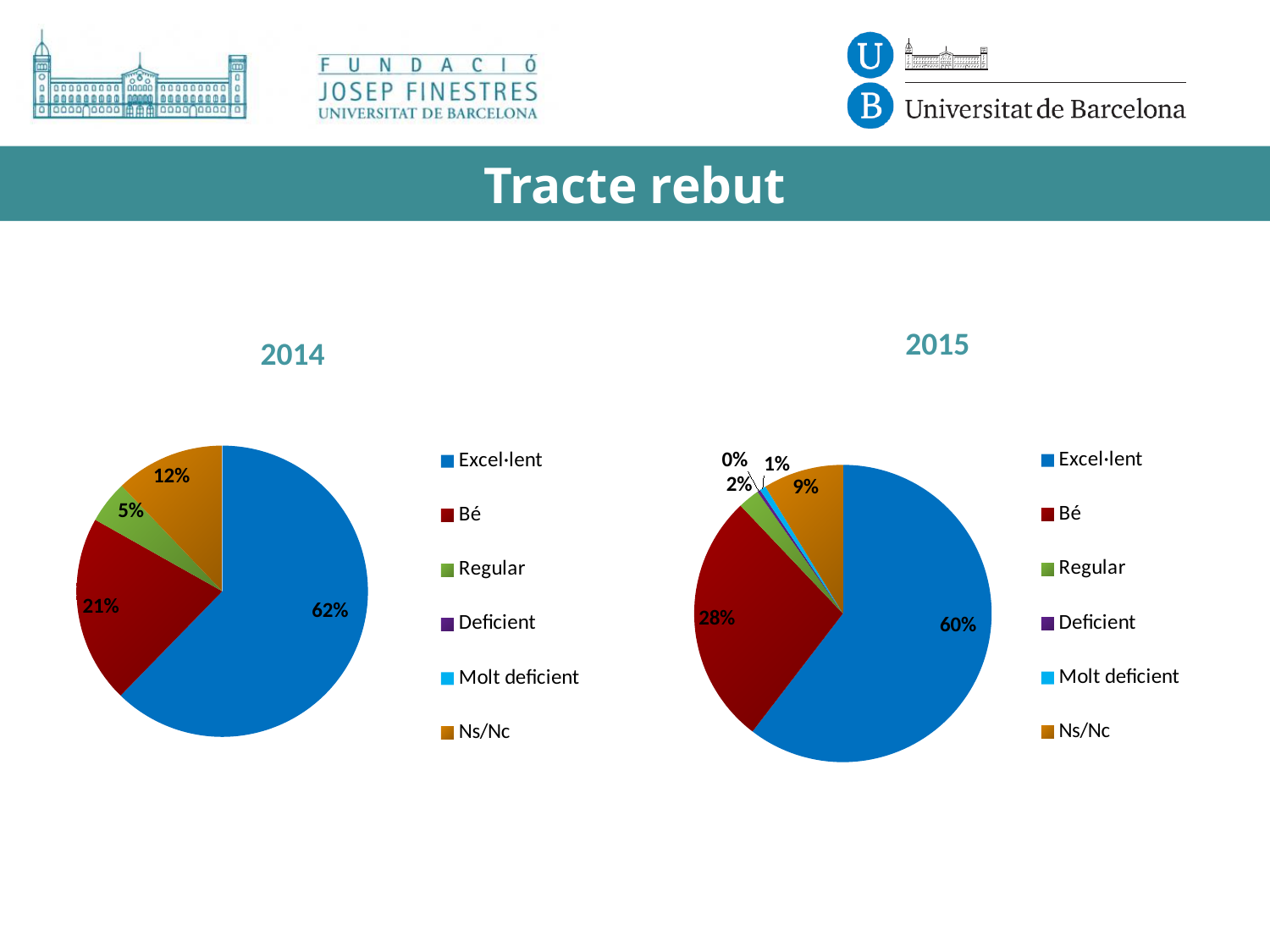
In the 2015 pie chart, what percentage is shown for Bé? 28% What is the difference between the Bé percentage in the 2015 pie chart and the Bé percentage in the 2014 pie chart? 7% In the 2015 pie chart, which category has the largest slice? Excel·lent What type of chart is used for the 2015 data? Pie chart In the 2015 pie chart, what percentage is shown for Excel·lent? 60% In the 2014 pie chart, what percentage is shown for Excel·lent? 62% In the 2015 pie chart, what percentage is shown for Ns/Nc? 9% In the 2014 pie chart, what percentage is shown for Ns/Nc? 12% In the 2014 pie chart, which category has the largest slice? Excel·lent In the 2015 pie chart, what percentage is shown for Regular? 2% In the 2014 pie chart, what percentage is shown for Bé? 21% How many entries does the legend of the 2014 pie chart list? 6